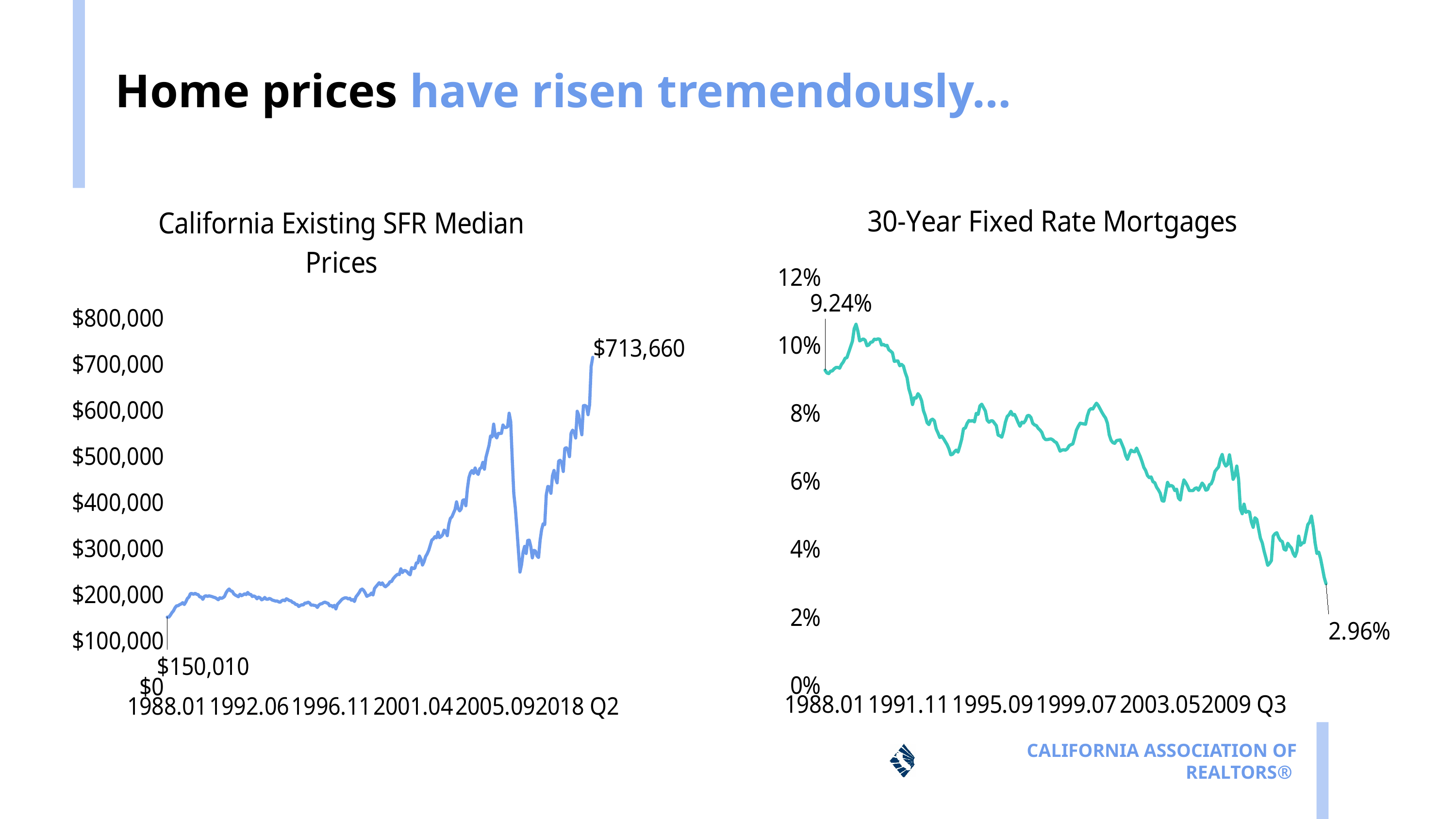
What is the title of the chart on the right side of the slide? 30-Year Fixed Rate Mortgages On the California Existing SFR Median Prices chart, which labelled value is larger: the start value or the end value? The end value ($713,660) What kind of chart is the California Existing SFR Median Prices chart? Line chart On the 30-Year Fixed Rate Mortgages chart, what is the rate labelled at the end of the series? 2.96% On the 30-Year Fixed Rate Mortgages chart, is the labelled start rate greater or less than 8%? greater On the 30-Year Fixed Rate Mortgages chart, what is the rate labelled at the start of the series? 9.24% On the 30-Year Fixed Rate Mortgages chart, do the values generally rise or fall from left to right? Fall On the California Existing SFR Median Prices chart, do the values generally rise or fall from left to right? Rise On the California Existing SFR Median Prices chart, what is the difference between the labelled end value ($713,660) and the labelled start value ($150,010)? $563,650 On the California Existing SFR Median Prices chart, what is the median price labelled at the start of the series (1988.01)? $150,010 On the 30-Year Fixed Rate Mortgages chart, how much lower is the labelled end rate (2.96%) than the labelled start rate (9.24%)? 6.28%